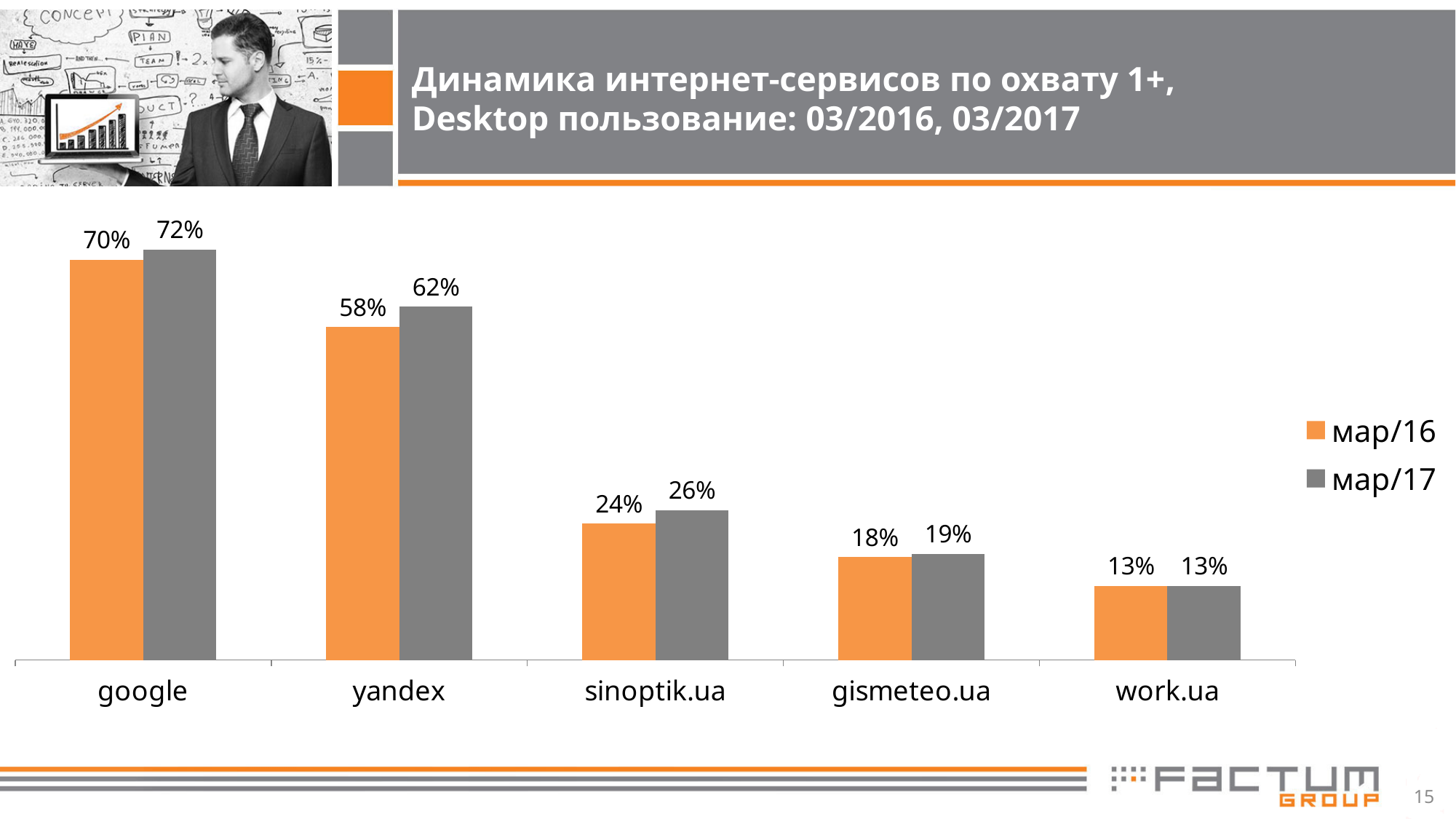
What is the value for work.ua in the мар/16 series? 13% Which category has the lowest value in the мар/16 series? work.ua Which category has the highest value in the мар/17 series? google What is the value for yandex in the мар/16 series? 58% What is the difference between the мар/17 and мар/16 values for yandex? 4% How many categories are shown on the x axis? 5 What kind of chart is shown on the slide? bar chart Which is larger for gismeteo.ua: the мар/16 value or the мар/17 value? мар/17 Which colour represents the мар/16 series in the legend? orange What is the value for google in the мар/17 series? 72% What is the value for sinoptik.ua in the мар/17 series? 26% How many series does the legend list? 2